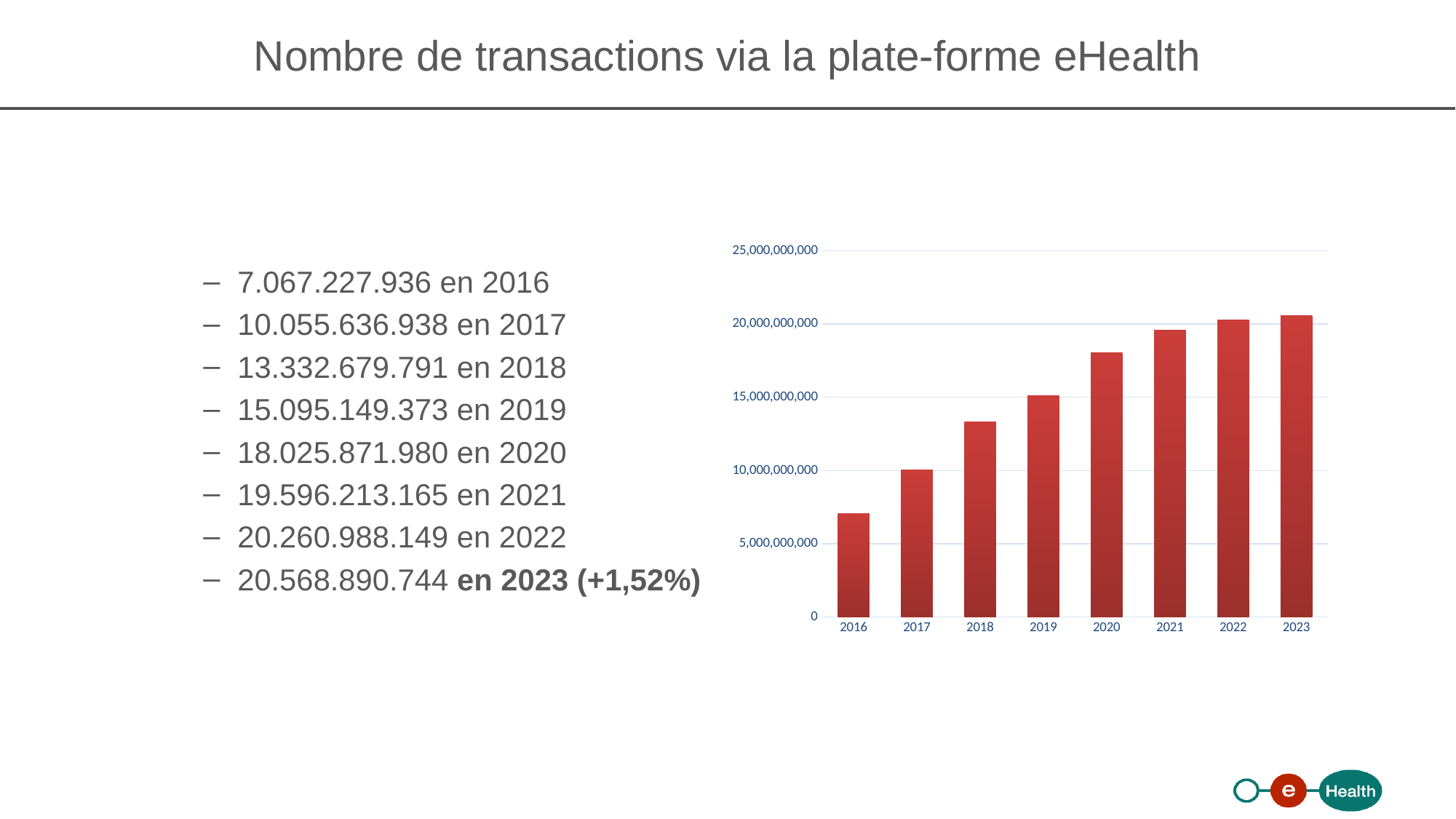
Is the value for 2020 greater or less than 15,000,000,000? greater Which year has more transactions, 2019 or 2020? 2020 What is the number of transactions in 2016, as printed on the slide? 7.067.227.936 Do the values in the chart rise or fall from 2016 to 2023? rise What is the title of the slide containing the chart? Nombre de transactions via la plate-forme eHealth How many years (bars) does the chart show? 8 What is the number of transactions in 2023, as printed on the slide? 20.568.890.744 What kind of chart is shown on the slide? bar chart Which year has the highest number of transactions in the chart? 2023 Is the value for 2021 greater or less than 20,000,000,000? less Which year has the lowest number of transactions in the chart? 2016 Is the value for 2016 greater or less than 10,000,000,000? less